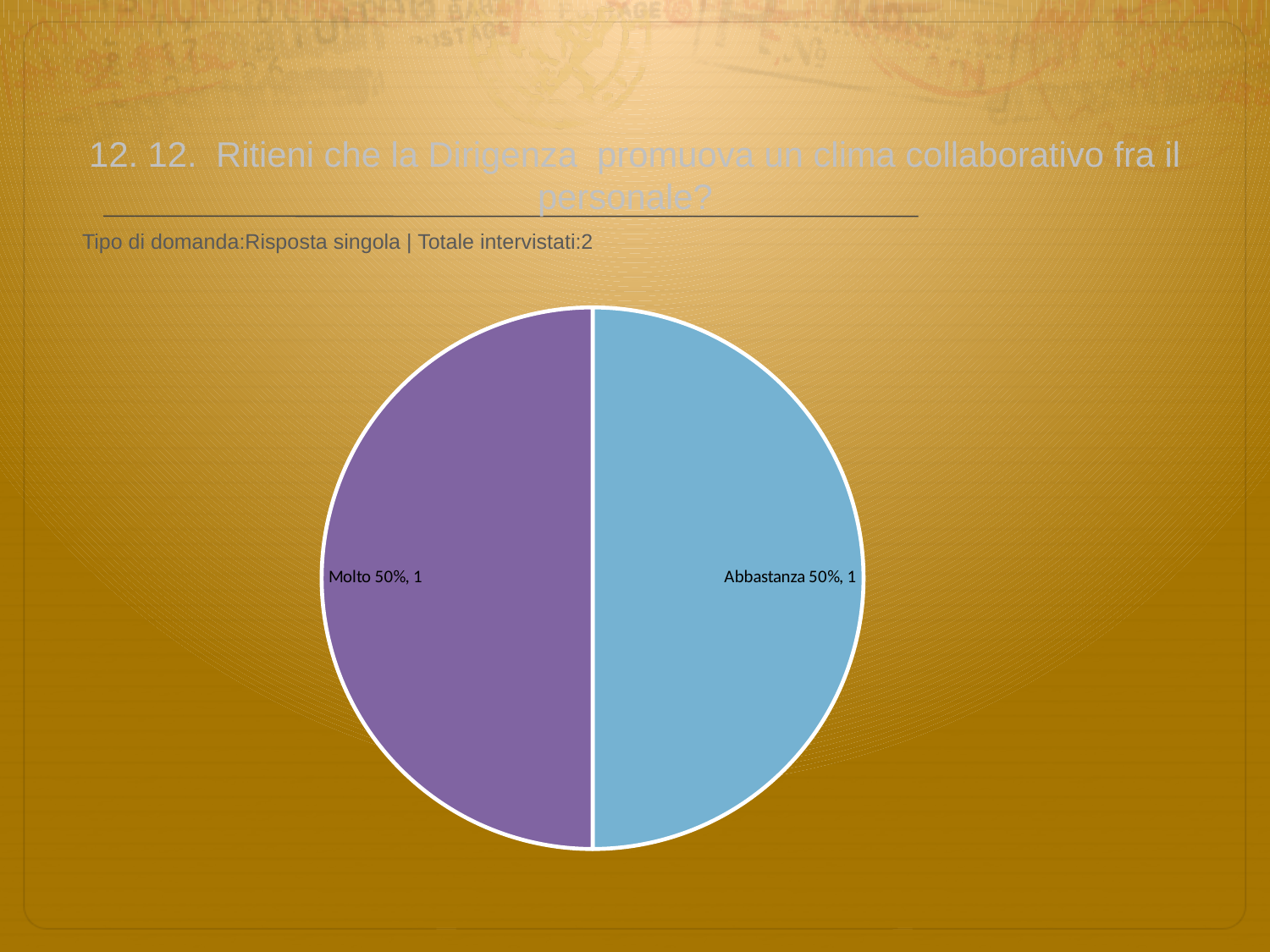
What percentage share does the Abbastanza slice have? 50% Which slice of the pie is coloured light blue? Abbastanza Which slice of the pie is coloured purple? Molto What is the count value shown for Molto? 1 What is the difference between the values for Molto and Abbastanza? 0 What kind of chart is shown on the slide? pie chart What is the count value shown for Abbastanza? 1 What is the total number of respondents shown on the slide? 2 What percentage share does the Molto slice have? 50% How many slices does the pie chart have? 2